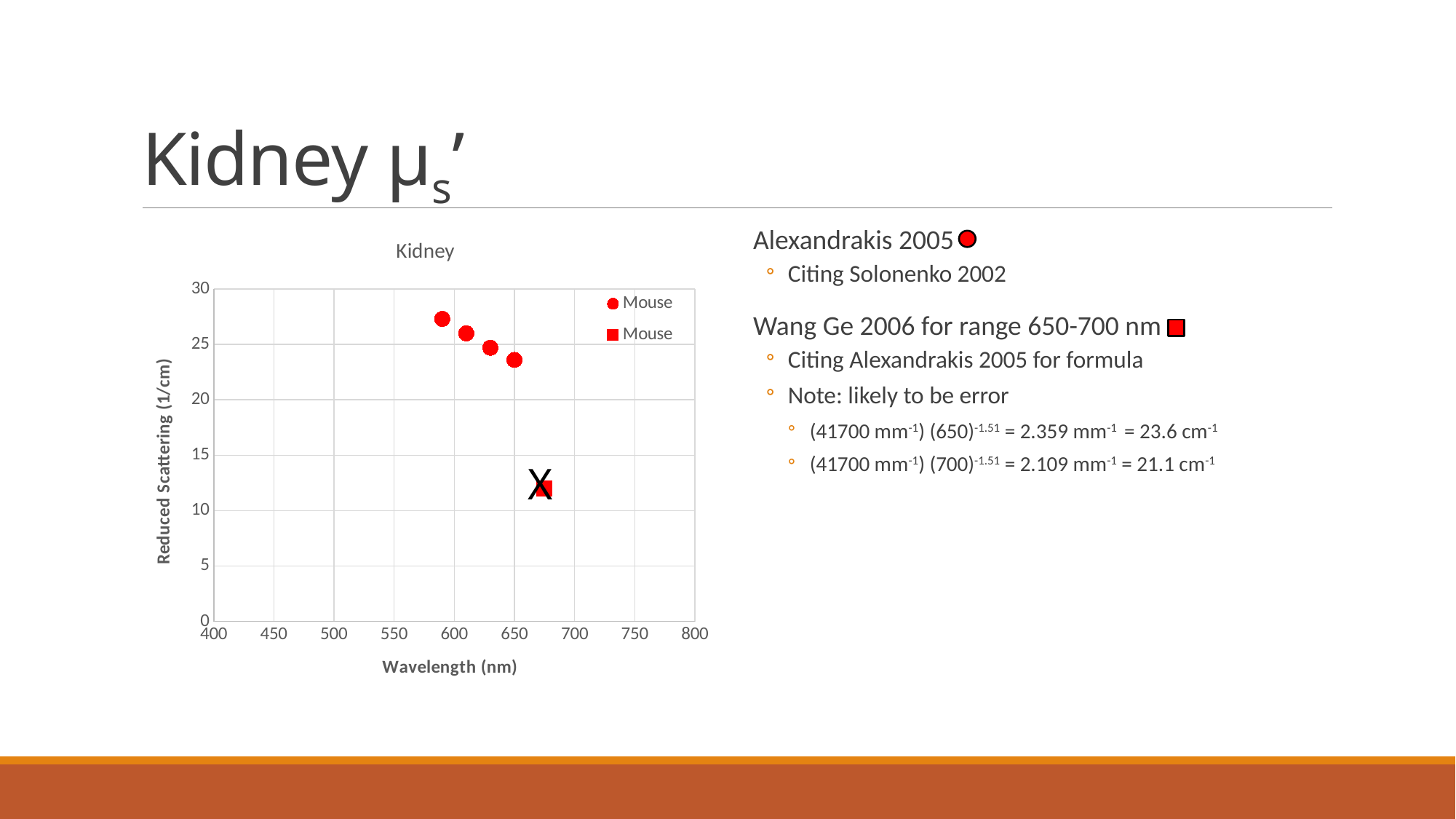
What kind of chart is shown on the slide? scatter chart What is the label on the chart's vertical axis? Reduced Scattering (1/cm) Is the value of the rightmost circle-marker point (near 650 nm) greater or less than 20? greater How many square-marker data points are plotted on the chart? 1 How many circle-marker data points are plotted on the chart? 4 Which plotted point has the lowest reduced scattering value? the square-marker point Is the value of the square-marker point greater or less than 10? greater Is the value of the square-marker point greater or less than 15? less Which is larger: the value of the rightmost circle-marker point or the value of the square-marker point? the circle-marker point Do the circle-marker values rise or fall as wavelength increases? fall How many series does the chart legend list? 2 What is the title of the chart? Kidney